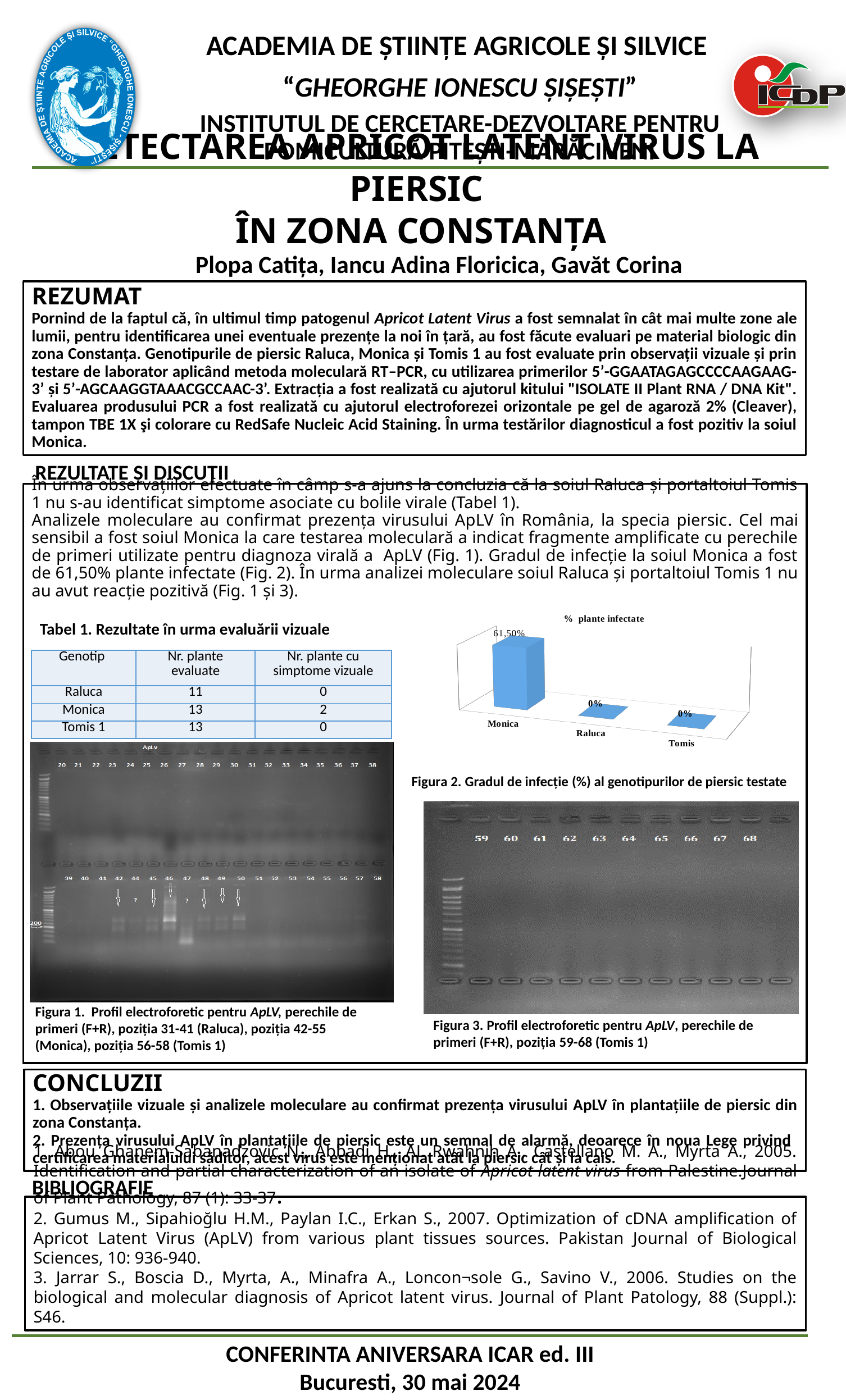
How many categories are shown in the chart? 3 Which genotype has the highest percentage of infected plants in the chart? Monica What is the value for Tomis in the chart? 0% What type of chart is shown on the slide? bar chart What is the value for Raluca in the chart? 0% What is the title of the chart on the slide? % plante infectate What is the difference between the values for Monica and Raluca in the chart? 61,50% What colour are the bars in the chart? blue Do the values in the chart rise or fall from Monica to Tomis along the x axis? fall Which is larger in the chart, the value for Monica or the value for Tomis? Monica What is the value for Monica in the chart? 61,50%